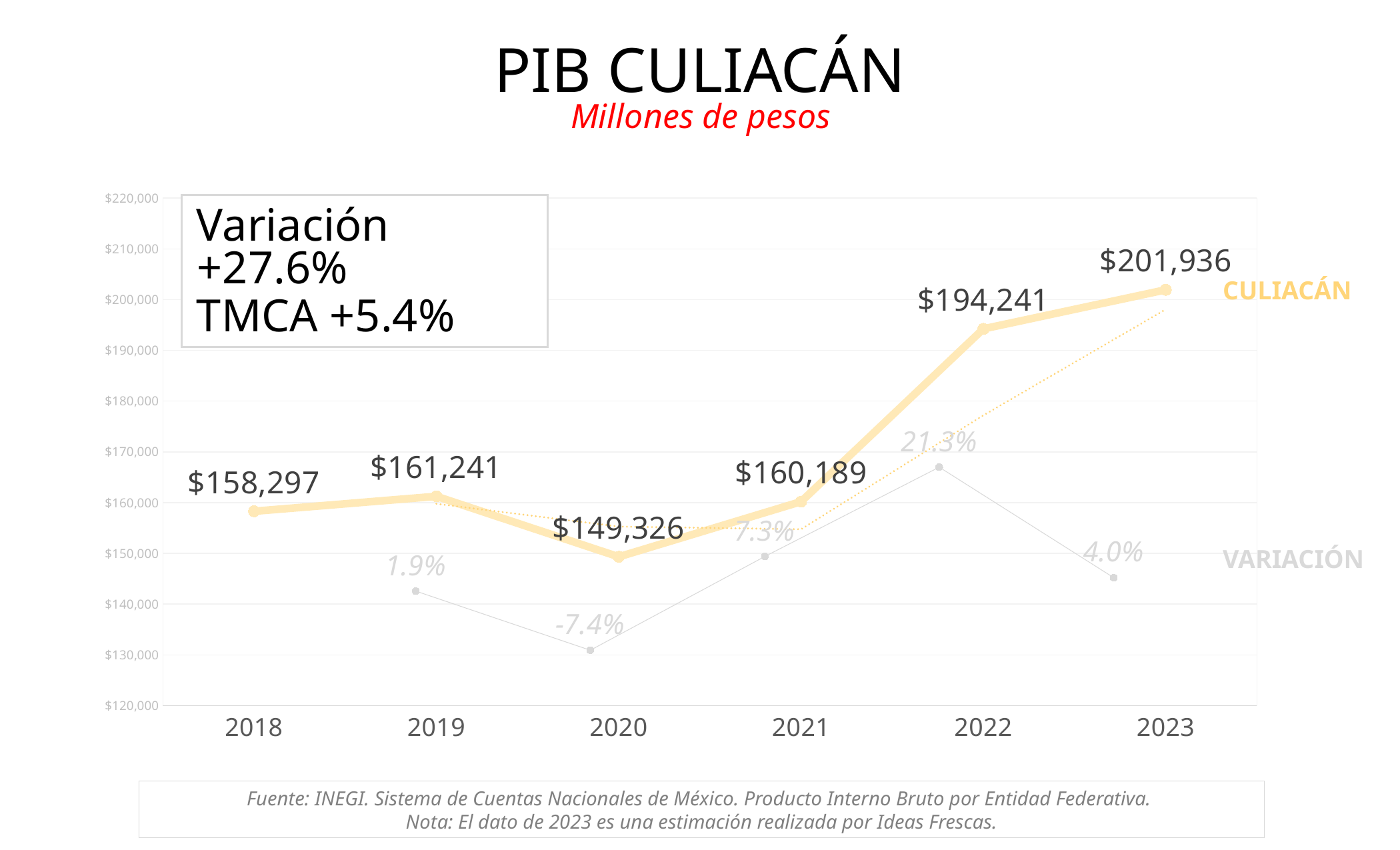
How many years are plotted on the x axis? 6 Does the Culiacán PIB line rise or fall from 2021 to 2023? Rise What is the PIB value for Culiacán in 2020? $149,326 What is the Variación value shown for 2020? -7.4% What is the difference between the Culiacán PIB values for 2023 and 2022? $7,695 Which year has the lowest PIB value for Culiacán? 2020 What type of chart is shown on the slide? Line chart Which is larger, the Culiacán PIB value for 2019 or for 2021? 2019 Which year has the highest PIB value for Culiacán? 2023 What is the subtitle shown under the chart title 'PIB CULIACÁN'? Millones de pesos What is the Variación value shown for 2022? 21.3% What is the PIB value for Culiacán in 2023? $201,936